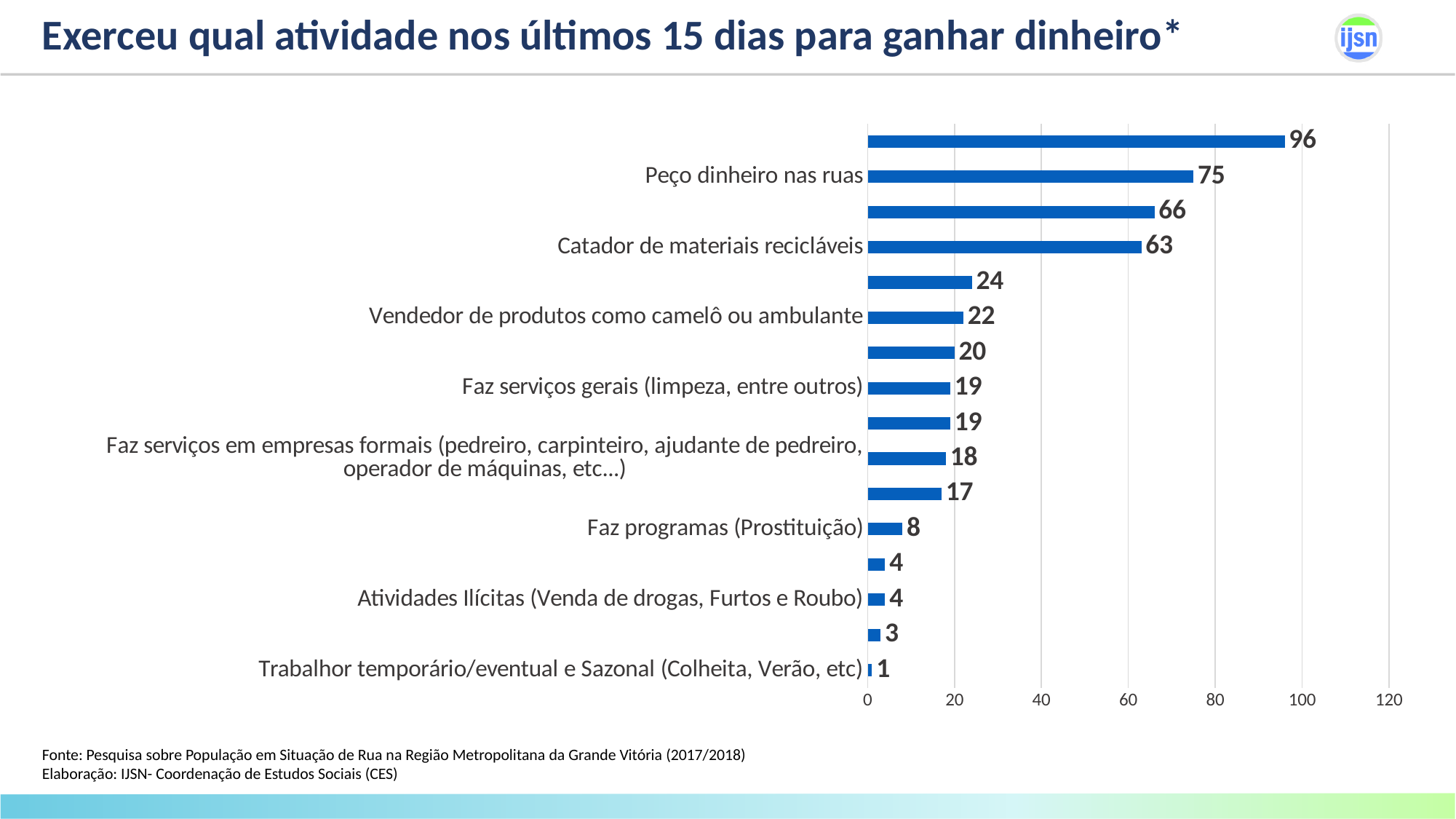
What kind of chart is shown on the slide? bar chart Which labelled category has the lowest value? Trabalhor temporário/eventual e Sazonal (Colheita, Verão, etc) What is the value for "Peço dinheiro nas ruas"? 75 What is the difference between the values for "Peço dinheiro nas ruas" and "Catador de materiais recicláveis"? 12 What is the highest value shown on any bar in the chart? 96 What is the value for "Faz programas (Prostituição)"? 8 What is the title of the slide? Exerceu qual atividade nos últimos 15 dias para ganhar dinheiro* What is the value for "Catador de materiais recicláveis"? 63 What is the value for "Vendedor de produtos como camelô ou ambulante"? 22 How many bars are plotted in the chart? 16 What is the value for "Faz serviços em empresas formais (pedreiro, carpinteiro, ajudante de pedreiro, operador de máquinas, etc...)"? 18 Which is larger: the value for "Faz serviços gerais (limpeza, entre outros)" or the value for "Faz programas (Prostituição)"? Faz serviços gerais (limpeza, entre outros)